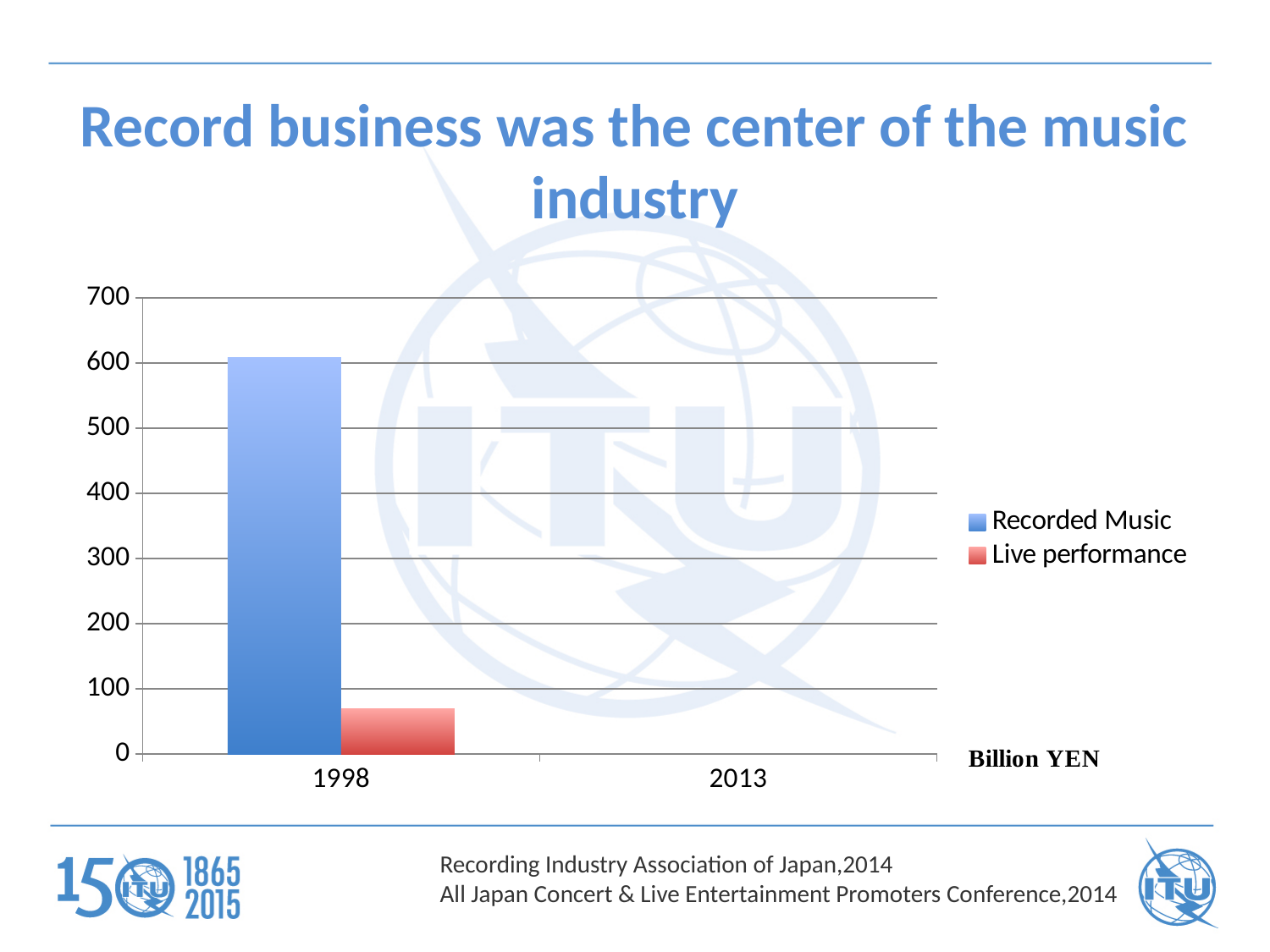
Is the value for Recorded Music in 1998 greater or less than 500? greater What are the two series named in the legend? Recorded Music, Live performance What unit is shown next to the chart's axis? Billion YEN Is the value for Live performance in 1998 greater or less than 100? less Is the value for Recorded Music in 1998 greater or less than 700? less What is the highest value shown on the y axis? 700 Which series has the larger value in 1998, Recorded Music or Live performance? Recorded Music How many years are labelled on the x axis? 2 What kind of chart is shown on the slide? bar chart How many series does the legend list? 2